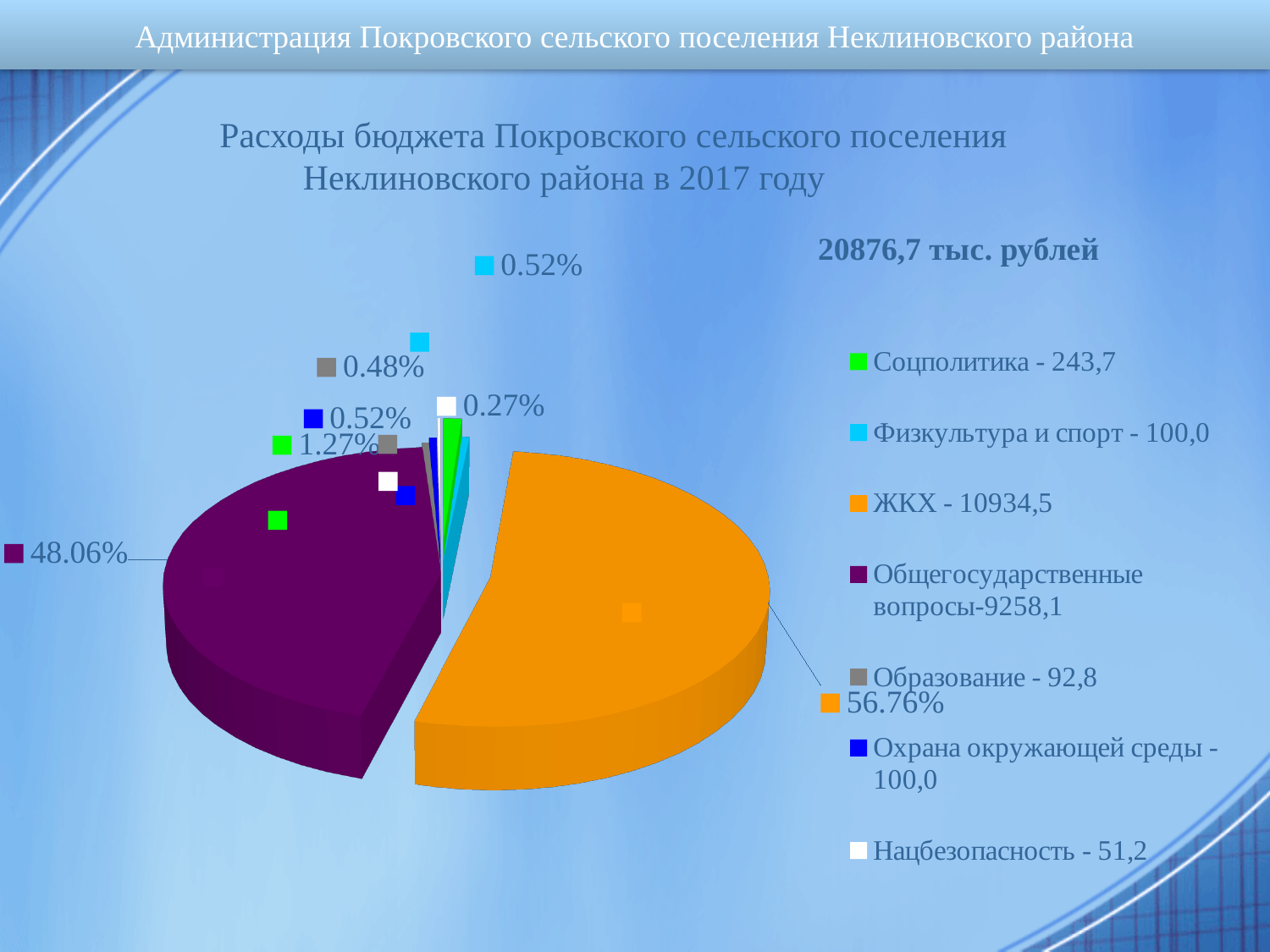
What value is given for Соцполитика in the legend? 243,7 How many categories does the pie chart's legend list? 7 What total amount is shown next to the chart title? 20876,7 тыс. рублей What value is given for ЖКХ in the legend? 10934,5 Which is larger, the value for Образование or the value for Нацбезопасность? Образование What percentage share is labelled on the orange ЖКХ slice? 56.76% What value is given for Общегосударственные вопросы in the legend? 9258,1 Which category has the smallest slice of the pie chart? Нацбезопасность Which category has the largest slice of the pie chart? ЖКХ What kind of chart is shown on the slide? Pie chart What percentage share is labelled on the purple Общегосударственные вопросы slice? 48.06% What is the difference between the legend values for ЖКХ and Общегосударственные вопросы? 1676,4